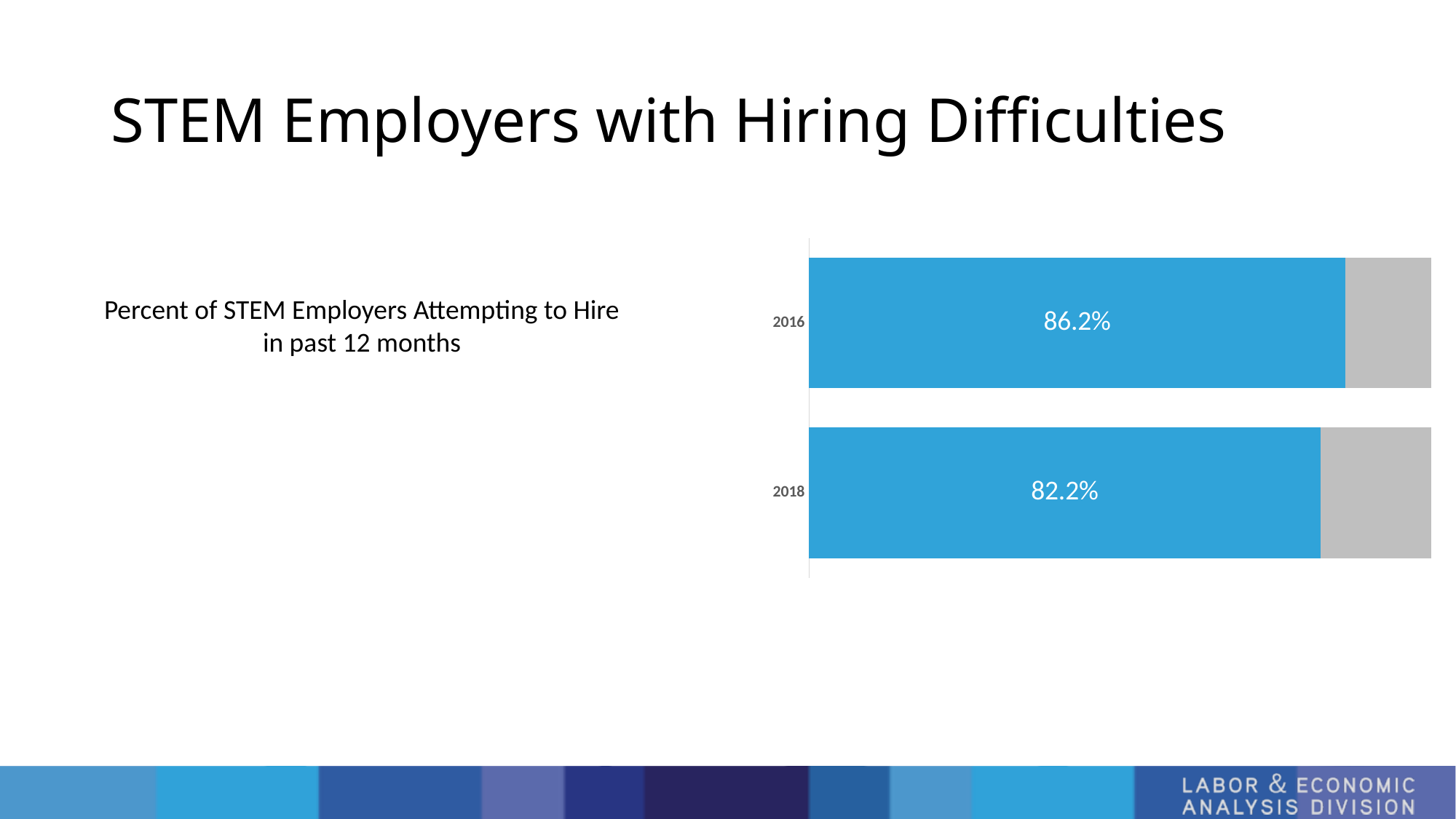
Is the value for 2016 larger or smaller than the value for 2018? larger What percent of STEM employers attempted to hire in the past 12 months in 2016? 86.2% Which year has the lower percent of STEM employers attempting to hire? 2018 What colour are the bars representing the percent of employers attempting to hire? blue What is the difference in percentage points between the 2016 and 2018 values? 4.0 percentage points Did the percent of STEM employers attempting to hire rise or fall from 2016 to 2018? fall What kind of chart is shown on the slide? bar chart Which year has the higher percent of STEM employers attempting to hire? 2016 What is the title of the slide? STEM Employers with Hiring Difficulties What percent of STEM employers attempted to hire in the past 12 months in 2018? 82.2% How many years are shown in the chart? 2